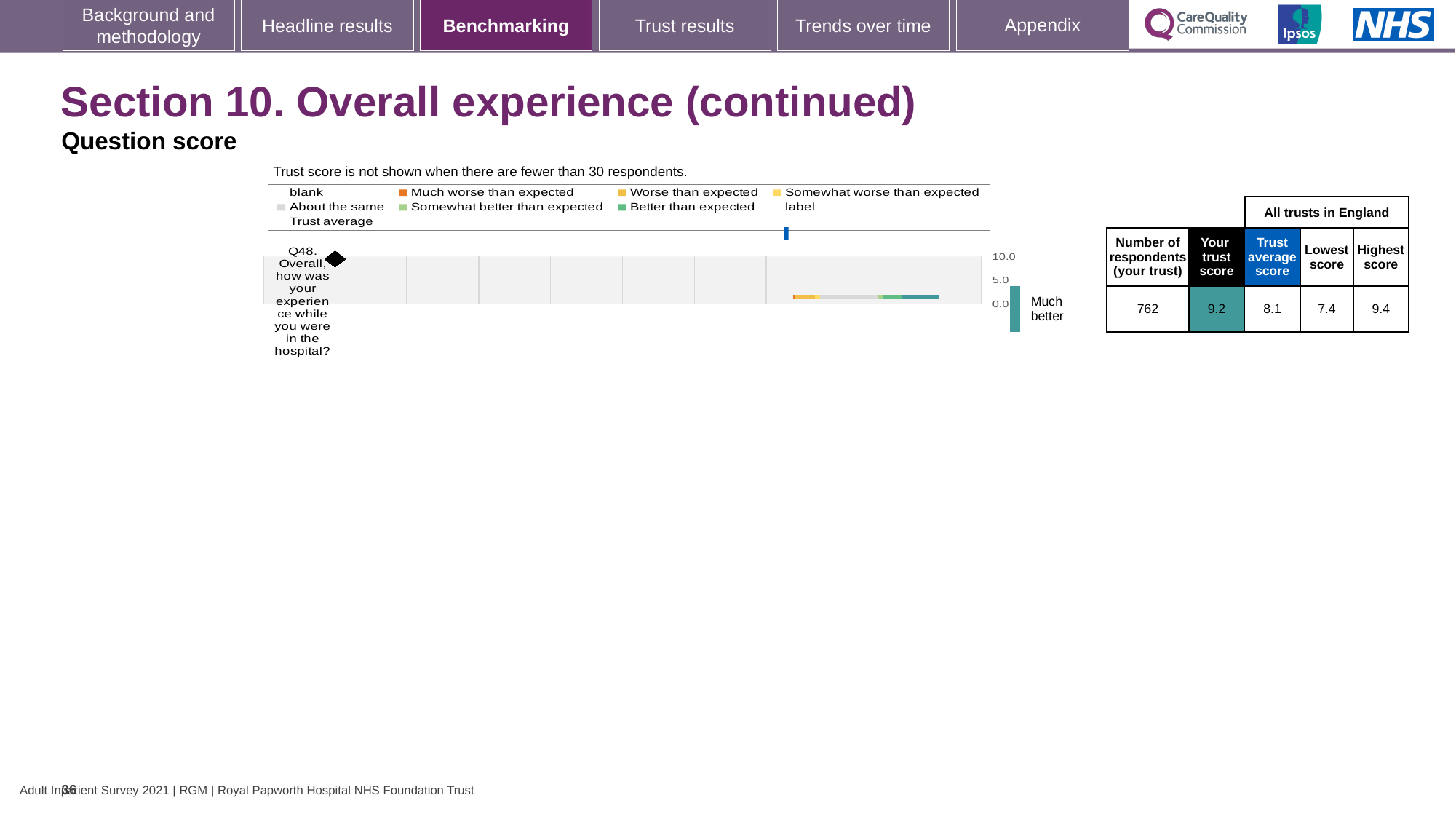
According to the table next to the chart, what is the lowest score among all trusts in England for Q48? 7.4 What is the difference between the trust score (9.2) and the trust average score (8.1) for Q48? 1.1 How many questions (categories) are plotted in the benchmarking chart? 1 According to the table next to the chart, what is the highest score among all trusts in England for Q48? 9.4 Which question is plotted in the benchmarking chart? Q48. Overall, how was your experience while you were in the hospital? How many respondents from the trust answered Q48? 762 According to the table next to the chart, what is the trust average score for Q48? 8.1 What is the highest value shown on the chart's score axis? 10.0 According to the table next to the chart, what is the trust score for Q48? 9.2 What is the difference between the highest score (9.4) and the lowest score (7.4) for Q48? 2.0 What kind of chart is shown for Q48 on the slide? bar chart Is the trust score for Q48 higher or lower than the trust average score? higher